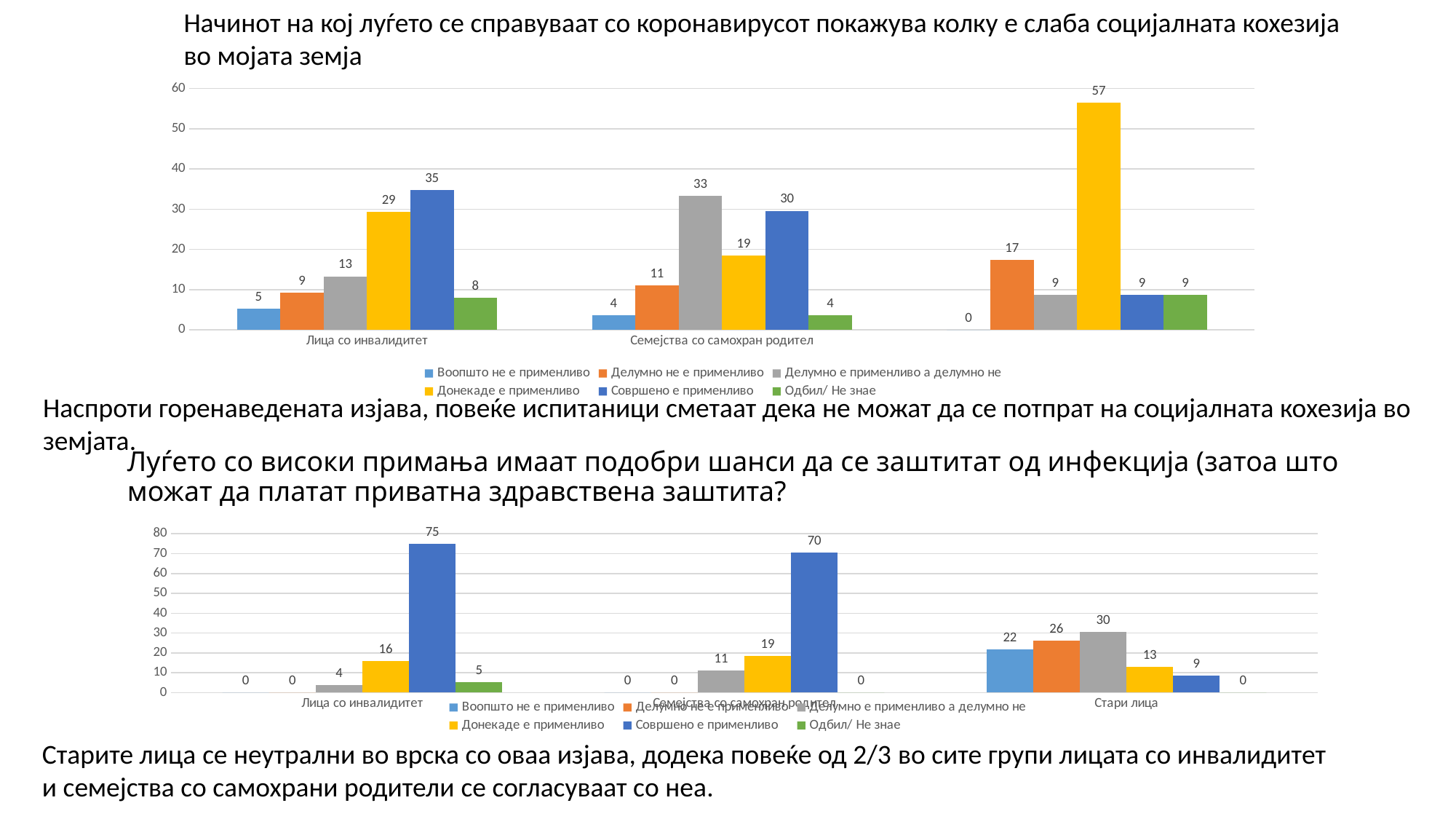
In the top chart, what is the value of 'Совршено е применливо' for 'Лица со инвалидитет'? 35 In the bottom chart, how many categories are shown on the x axis? 3 In the bottom chart, what is the value of 'Совршено е применливо' for 'Семејства со самохран родител'? 70 In the top chart, what is the difference between 'Донекаде е применливо' for 'Лица со инвалидитет' and for 'Семејства со самохран родител'? 10 In the bottom chart, which is larger: 'Совршено е применливо' for 'Лица со инвалидитет' or for 'Семејства со самохран родител'? Лица со инвалидитет In the top chart, which series has the highest value for 'Лица со инвалидитет'? Совршено е применливо What kind of chart is the top chart? Bar chart In the bottom chart, which series has the highest value for 'Стари лица'? Делумно е применливо а делумно не In the bottom chart, what is the value of 'Воопшто не е применливо' for 'Стари лица'? 22 In the top chart, what is the value of 'Делумно е применливо а делумно не' for 'Семејства со самохран родител'? 33 In the bottom chart, what is the difference between 'Совршено е применливо' for 'Лица со инвалидитет' and for 'Стари лица'? 66 In the top chart, how many series does the legend list? 6